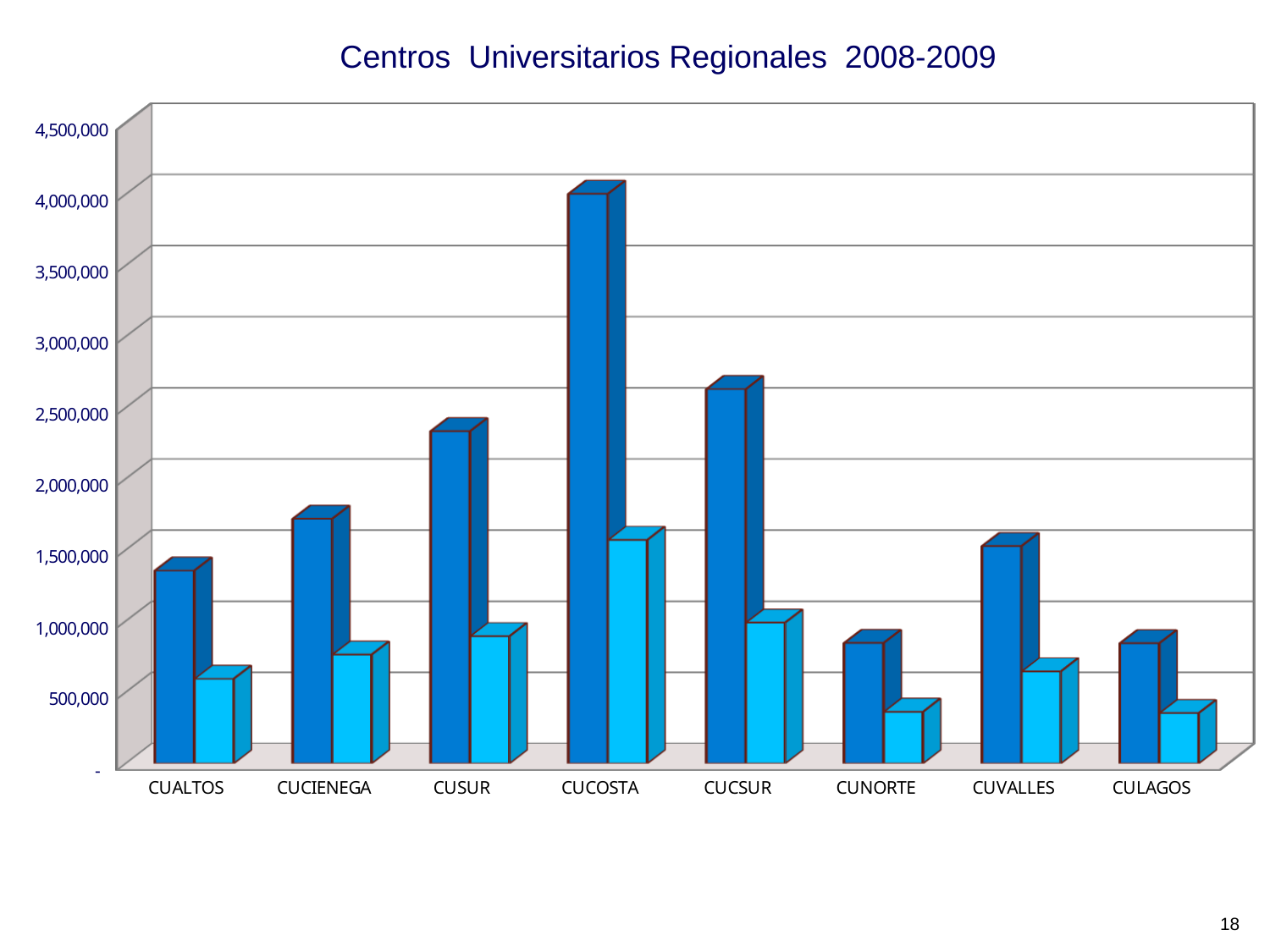
Is the dark blue bar for CUCOSTA greater or less than 3,500,000? greater Which category has the tallest light blue bar? CUCOSTA Is the dark blue bar for CUSUR greater or less than 2,000,000? greater What is the title of the chart? Centros Universitarios Regionales 2008-2009 Is the light blue bar for CUCOSTA greater or less than 1,000,000? greater How many university centres (categories) are shown on the x axis? 8 What kind of chart is shown on the slide? Bar chart Which category has the tallest dark blue bar? CUCOSTA Which has the taller dark blue bar, CUSUR or CUCSUR? CUCSUR In the CUVALLES category, which bar is taller, the dark blue one or the light blue one? The dark blue one